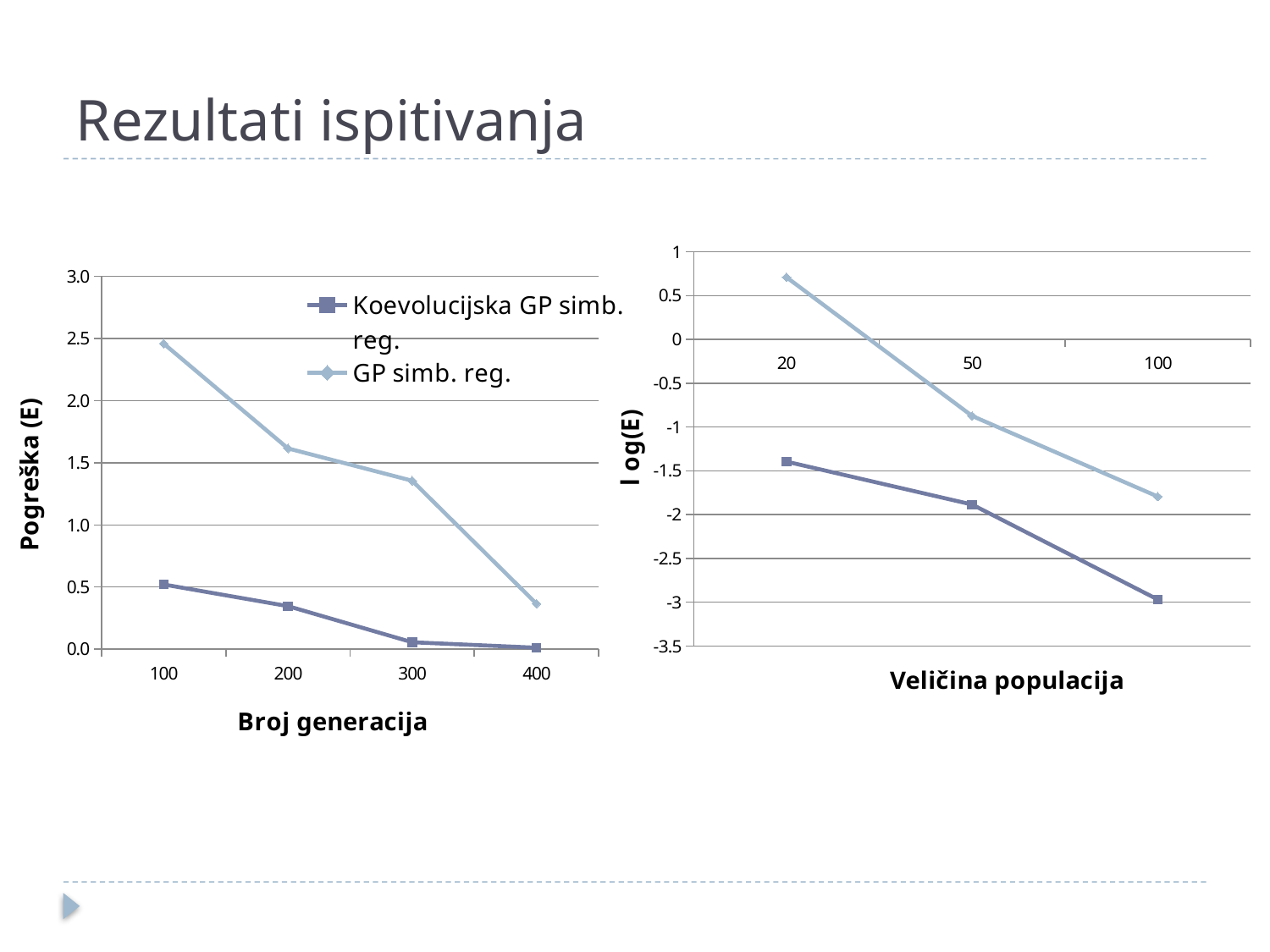
In the left chart, at 300 generations, which series has the larger error: GP simb. reg. or Koevolucijska GP simb. reg.? GP simb. reg. In the right chart (Veličina populacija), do both lines rise or fall as population size increases? fall How many x-axis categories does the left chart (Broj generacija) have? 4 In the left chart, is the value for GP simb. reg. at 400 generations greater or less than 0.5? less In the left chart, is the value for GP simb. reg. at 100 generations greater or less than 2.0? greater What kind of chart is the left chart (Broj generacija)? line chart How many series does the legend of the left chart list? 2 What is the x-axis title of the right chart? Veličina populacija In the left chart, is the value for Koevolucijska GP simb. reg. at 200 generations greater or less than 0.5? less How many x-axis categories does the right chart (Veličina populacija) have? 3 What is the y-axis title of the left chart? Pogreška (E) In the left chart, does the GP simb. reg. series rise or fall as the number of generations increases? fall